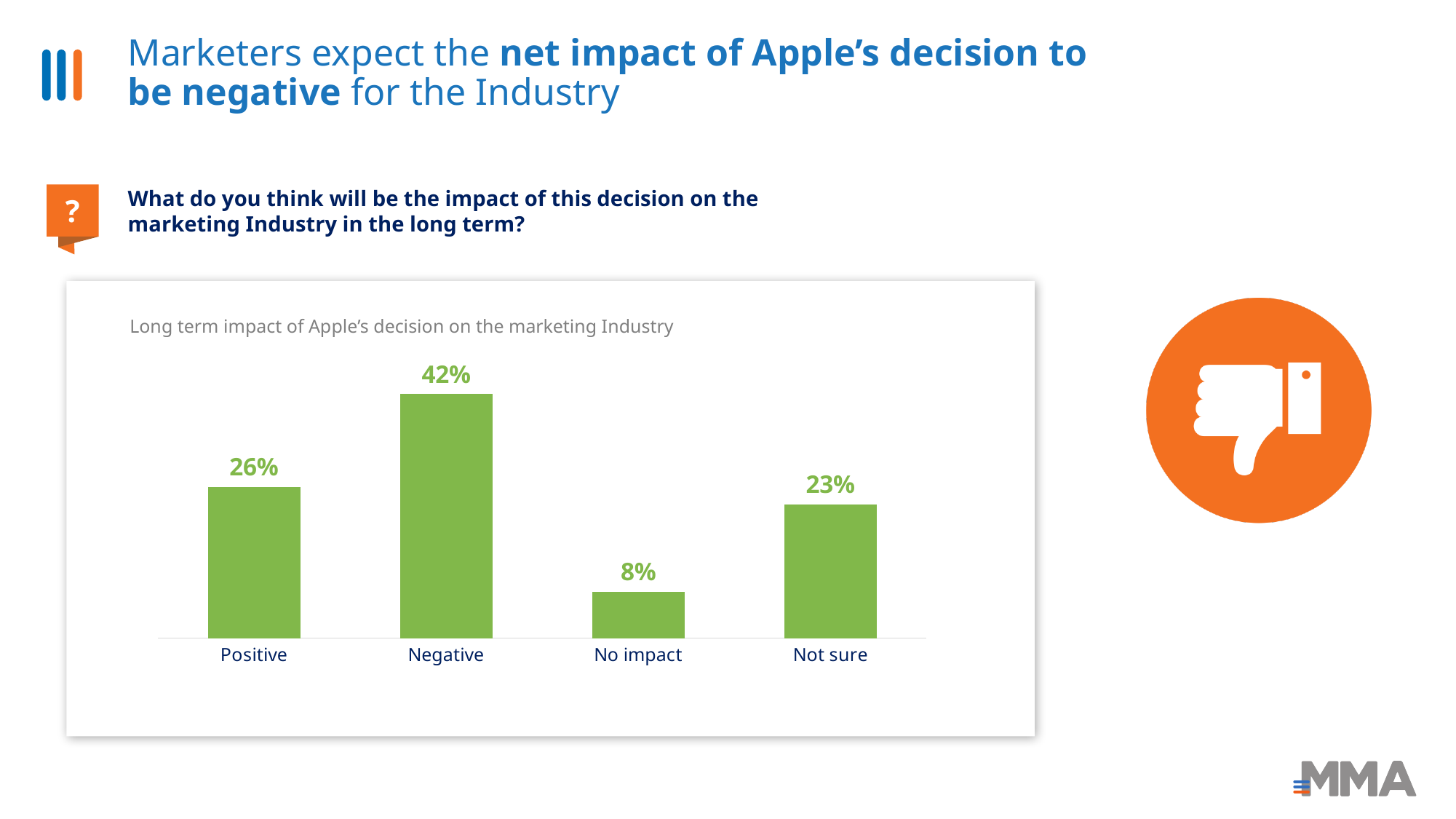
What share of respondents answered Not sure? 23% What is the difference between the Negative and Positive values? 16% What is the title of the chart? Long term impact of Apple's decision on the marketing Industry Which is larger, the value for Positive or the value for Not sure? Positive How many categories are shown on the chart? 4 What kind of chart is shown on the slide? Bar chart What percentage of marketers expect a negative long-term impact? 42% Which category has the highest value? Negative What is the value for No impact? 8% Which category has the lowest value? No impact What is the difference between the Positive and Not sure values? 3% What is the value for the Positive category? 26%